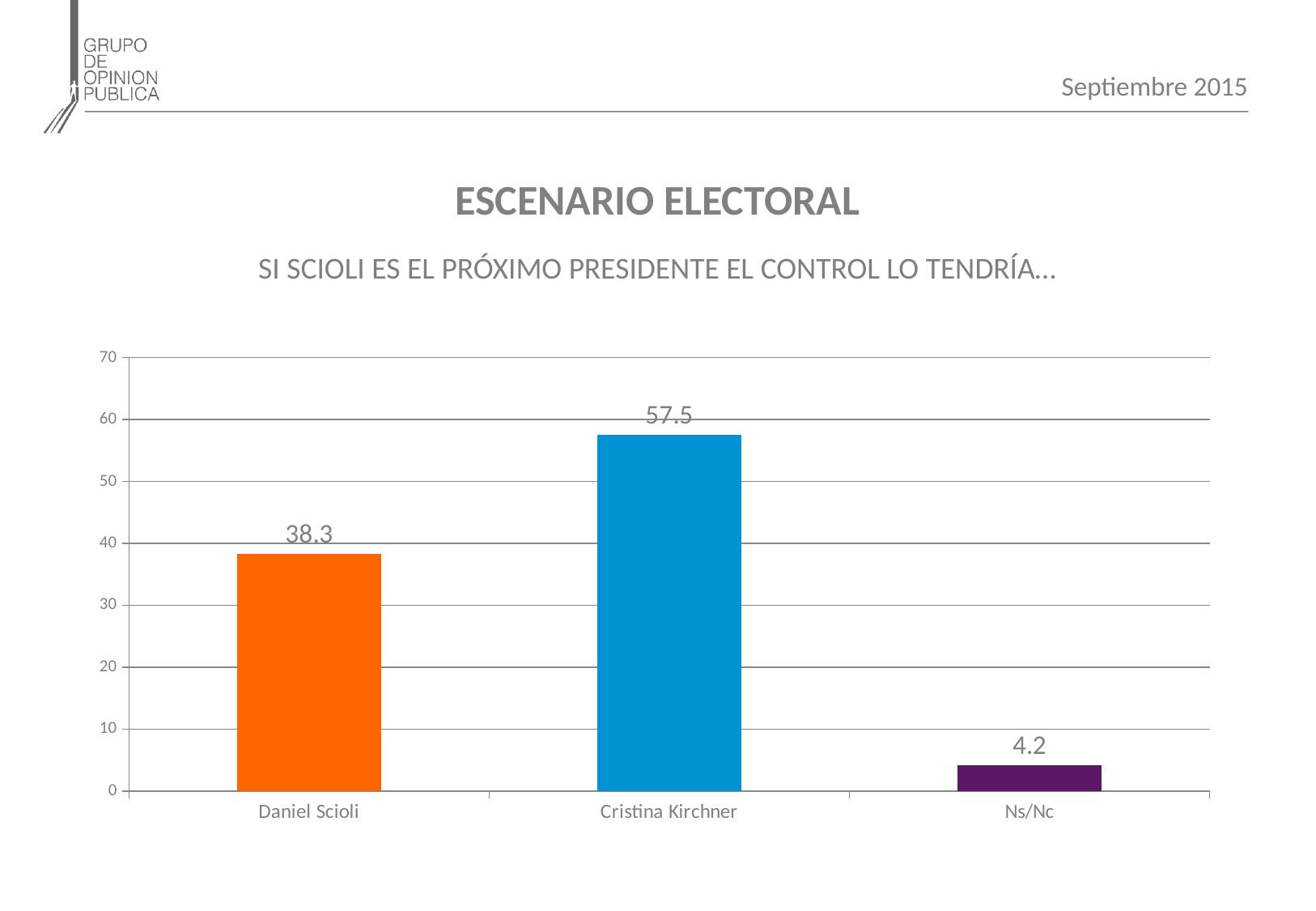
What is the value for Cristina Kirchner? 57.5 Which is larger, the value for Daniel Scioli or the value for Cristina Kirchner? Cristina Kirchner Is the value for Daniel Scioli greater or less than 40? less What kind of chart is shown on the slide? bar chart Which category has the lowest value? Ns/Nc What is the value for Ns/Nc? 4.2 What is the difference between the values for Cristina Kirchner and Daniel Scioli? 19.2 Which category has the highest value? Cristina Kirchner How many categories are shown on the x axis? 3 What is the value for Daniel Scioli? 38.3 What is the difference between the values for Daniel Scioli and Ns/Nc? 34.1 What is the subtitle shown above the chart? SI SCIOLI ES EL PRÓXIMO PRESIDENTE EL CONTROL LO TENDRÍA…